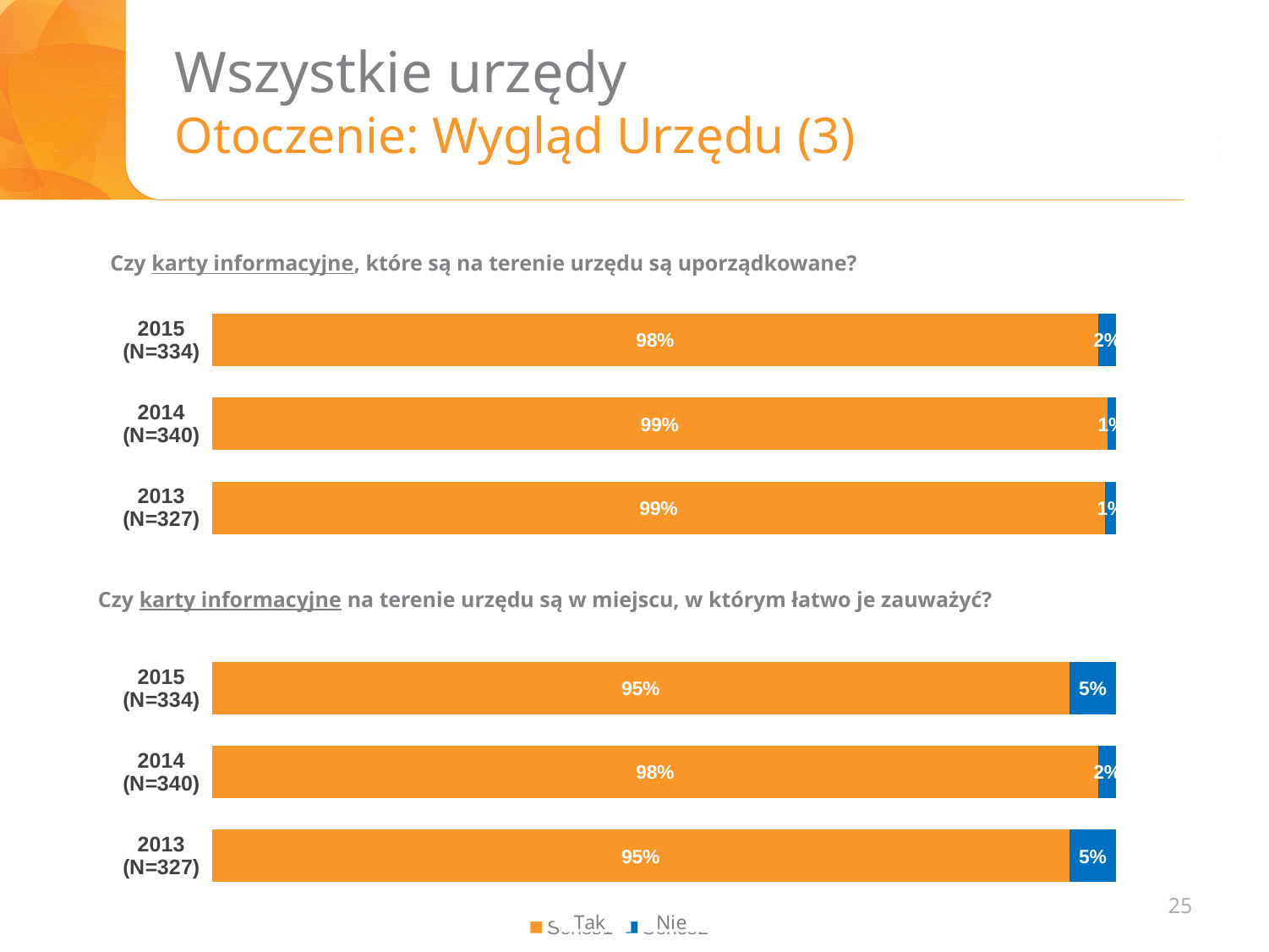
In the top chart, what percentage answered 'Tak' for 2013 (N=327)? 99% In the bottom chart, which year has the highest 'Tak' share? 2014 (N=340) How many year categories does the top chart show? 3 In the bottom chart, is the 'Nie' share larger for 2015 or for 2014? 2015 In the bottom chart, what is the difference between the 'Tak' share for 2014 and the 'Tak' share for 2015? 3% In the top chart, which year has the lowest 'Tak' share? 2015 (N=334) Which colour represents 'Nie' in the charts? Blue How many series does the legend list? 2 In the bottom chart, what percentage answered 'Nie' for 2015 (N=334)? 5% In the top chart, what percentage answered 'Tak' for 2015 (N=334)? 98% In the bottom chart, what percentage answered 'Tak' for 2014 (N=340)? 98% What type of chart is used on this slide? Stacked bar chart